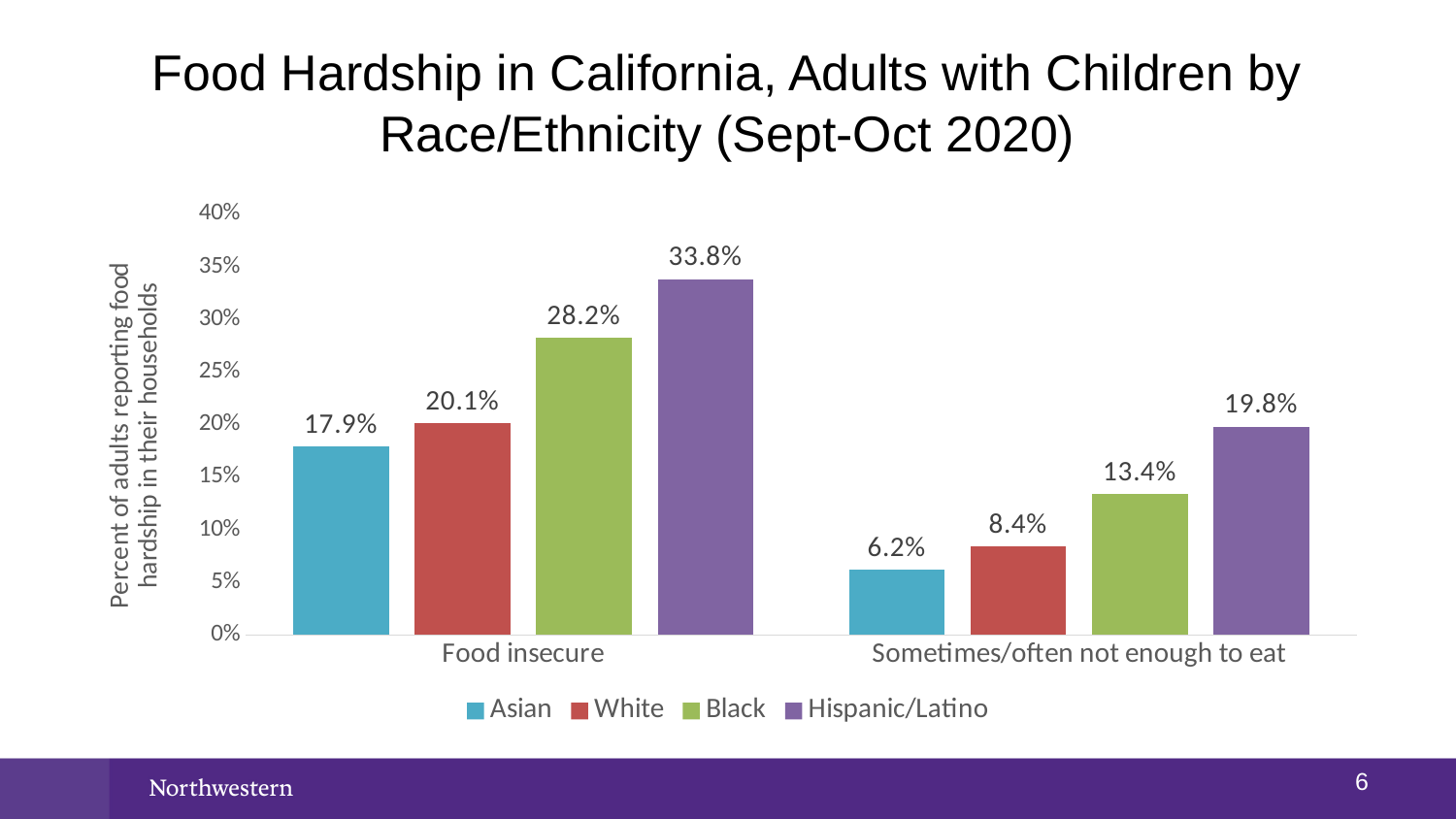
What is the value for Asian adults in the Sometimes/often not enough to eat category? 6.2% How many series does the legend list? 4 What is the value for Hispanic/Latino adults in the Food insecure category? 33.8% Which race/ethnicity group has the lowest value in the Sometimes/often not enough to eat category? Asian What kind of chart is shown on the slide? Bar chart What is the difference between the Black and White values in the Sometimes/often not enough to eat category? 5.0% Which is larger: the White value for Food insecure or the Hispanic/Latino value for Sometimes/often not enough to eat? White value for Food insecure What is the difference between the Hispanic/Latino and Asian values in the Food insecure category? 15.9% What is the value for Black adults in the Food insecure category? 28.2% Which race/ethnicity group has the highest value in the Food insecure category? Hispanic/Latino Is the value for Black adults in the Sometimes/often not enough to eat category greater or less than 15%? less How many categories are shown on the x axis? 2